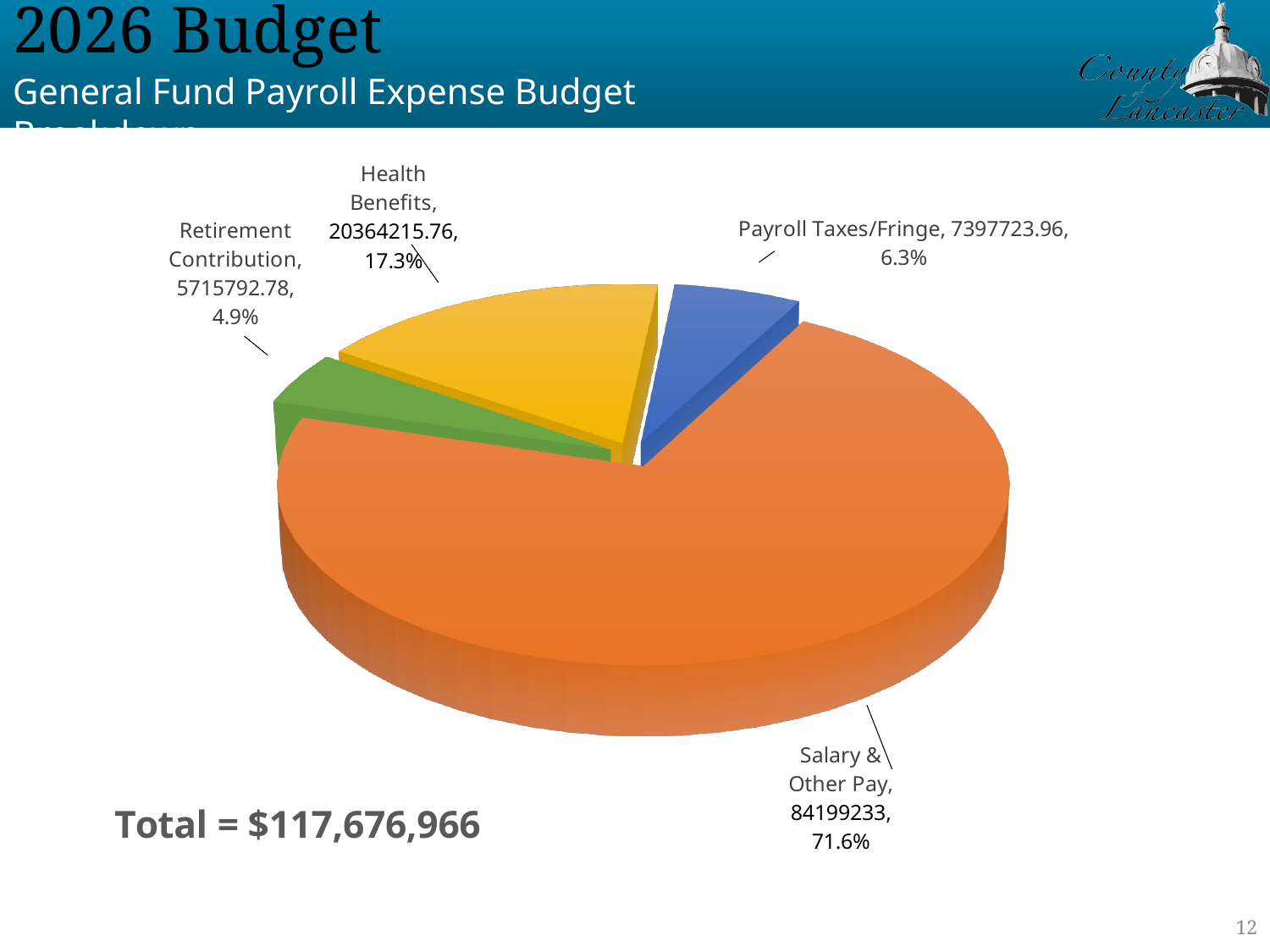
Which category has the largest share of the pie? Salary & Other Pay What share of the pie does Health Benefits represent? 17.3% What is the value for Retirement Contribution? 5715792.78 What is the value for Payroll Taxes/Fringe? 7397723.96 What is the value for Health Benefits? 20364215.76 Which is larger, Payroll Taxes/Fringe or Retirement Contribution? Payroll Taxes/Fringe What is the value for Salary & Other Pay? 84199233 What share of the pie does Payroll Taxes/Fringe represent? 6.3% Which category has the smallest share of the pie? Retirement Contribution What kind of chart is shown on the slide? Pie chart What total is stated on the slide for the payroll expense budget? $117,676,966 How many slices does the pie chart have? 4